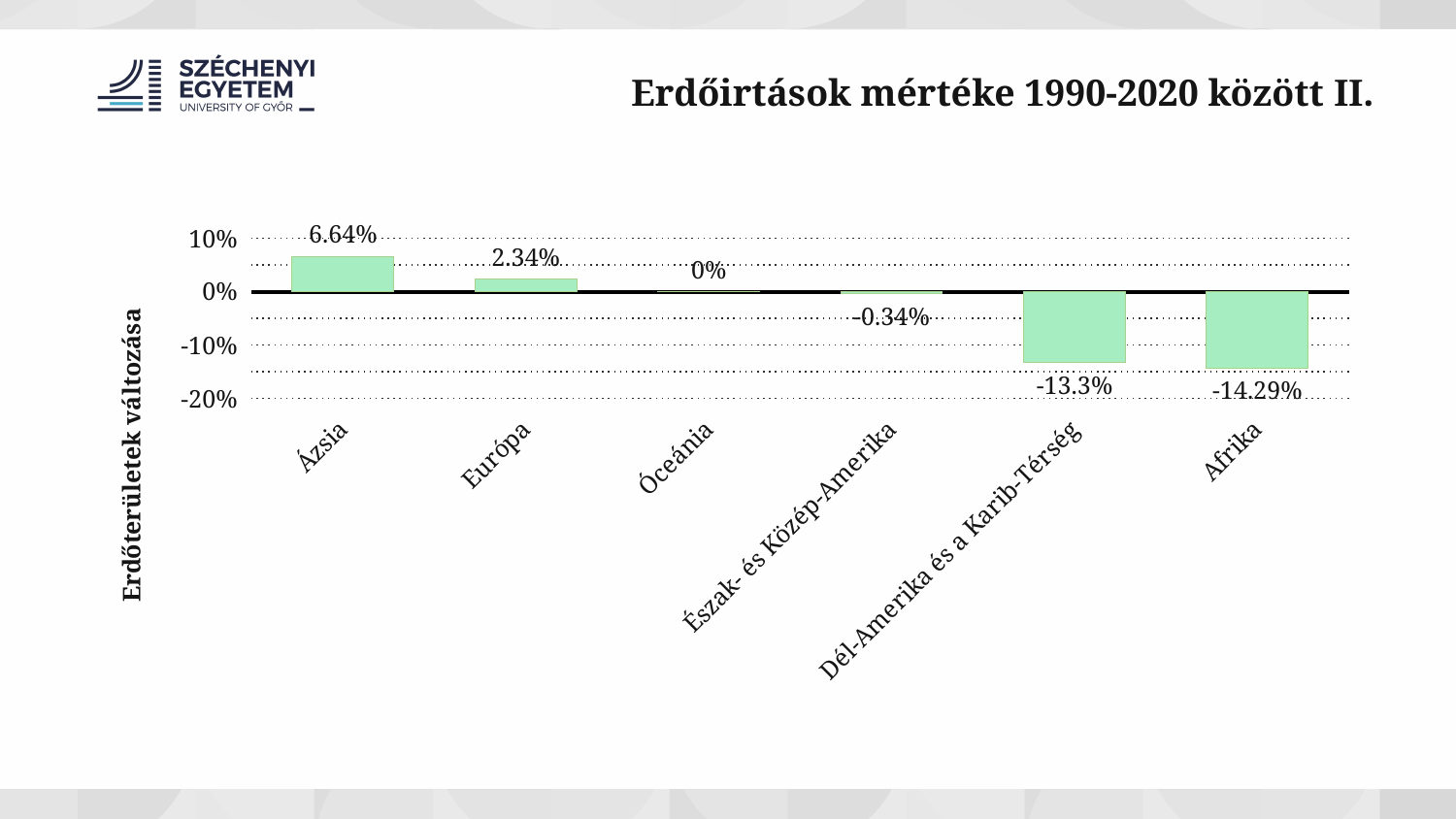
What is the value for Észak- és Közép-Amerika? -0.34% What is the value for Ázsia? 6.64% What is the difference between the values for Ázsia and Európa? 4.3% What kind of chart is shown on the slide? bar chart How many categories are shown on the x axis? 6 What is the label of the vertical axis? Erdőterületek változása Which is larger, the value for Európa or the value for Óceánia? Európa What is the value for Afrika? -14.29% Is the value for Dél-Amerika és a Karib-Térség greater or less than -10%? less Which category has the highest value? Ázsia Which category has the lowest value? Afrika What is the value for Dél-Amerika és a Karib-Térség? -13.3%